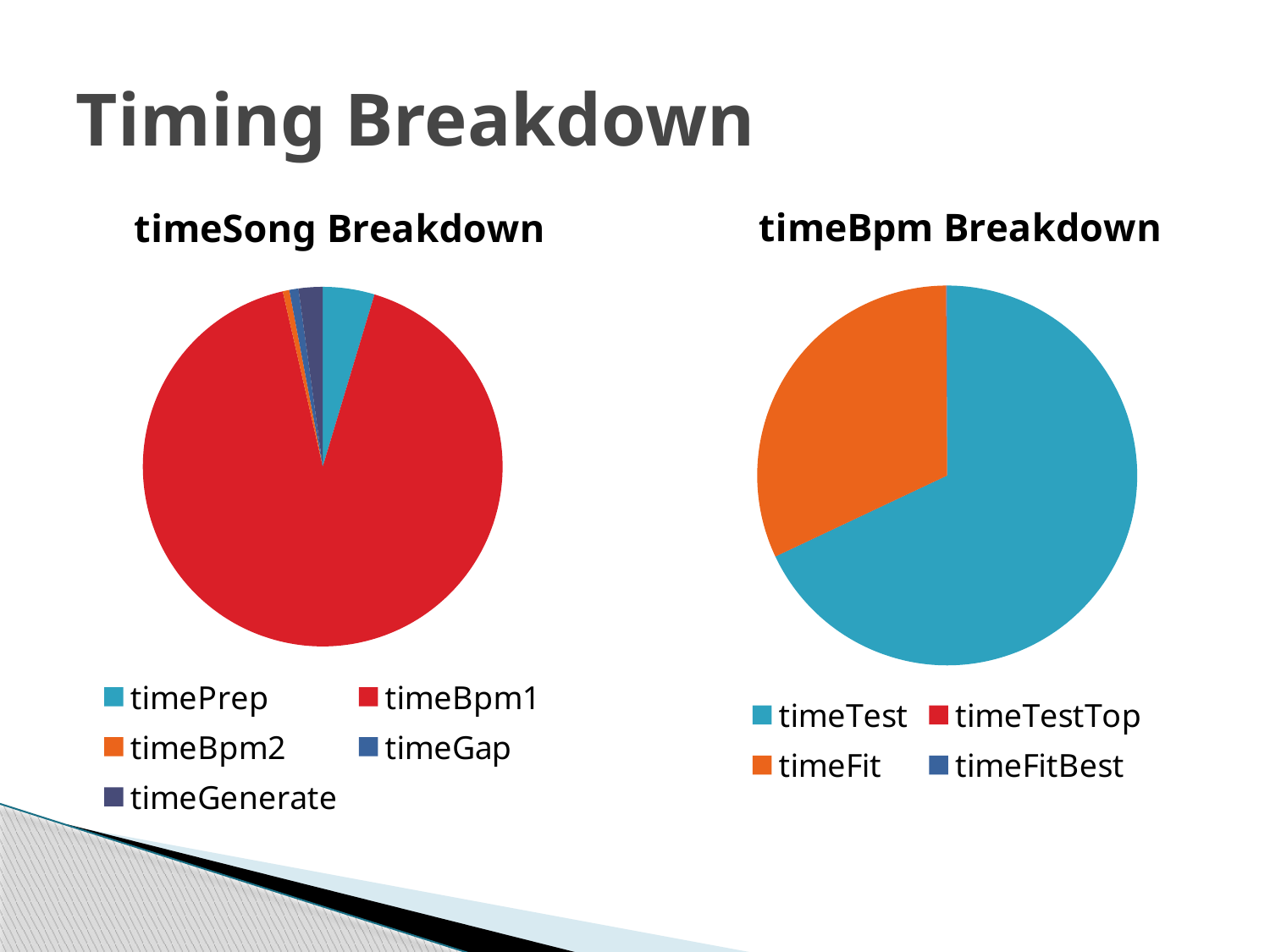
In the timeSong Breakdown chart, which slice is larger, timePrep or timeGenerate? timePrep In the timeBpm Breakdown chart, which slice is larger, timeTest or timeFit? timeTest In the timeBpm Breakdown chart, which category has the largest slice? timeTest How many categories does the legend of the timeSong Breakdown chart list? 5 How many categories does the legend of the timeBpm Breakdown chart list? 4 What kind of chart is the timeBpm Breakdown chart? pie chart In the timeSong Breakdown chart, which slice is larger, timeBpm1 or timePrep? timeBpm1 In the timeBpm Breakdown chart, what colour is the timeFit slice? orange What kind of chart is the timeSong Breakdown chart? pie chart What is the title of the chart on the left side of the slide? timeSong Breakdown In the timeSong Breakdown chart, which category has the largest slice? timeBpm1